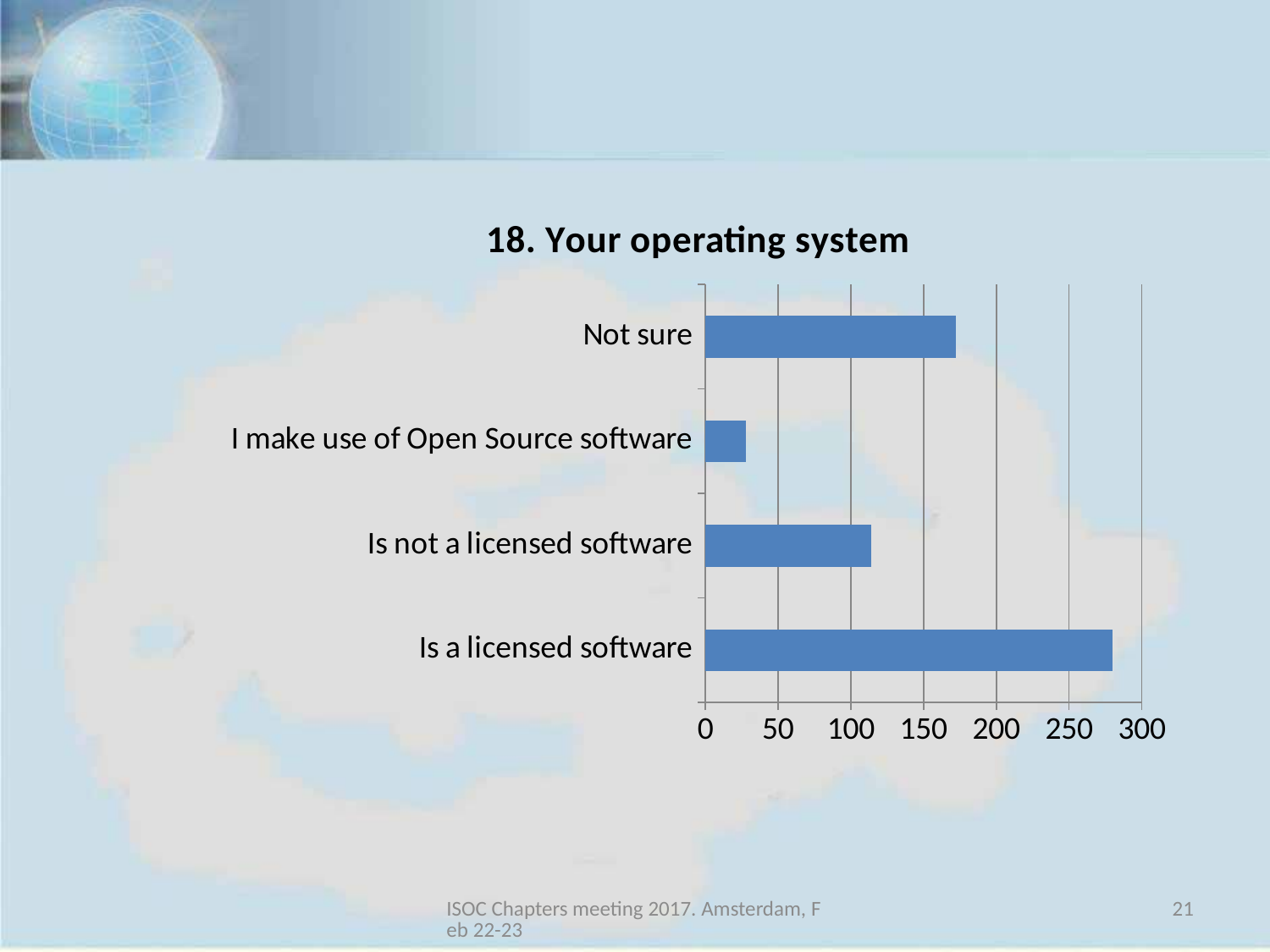
Which is larger, the value for 'Is a licensed software' or the value for 'Not sure'? Is a licensed software Which category has the lowest value? I make use of Open Source software Which category has the highest value? Is a licensed software Is the value for 'Not sure' greater or less than 150? greater Is the value for 'I make use of Open Source software' greater or less than 50? less Is the value for 'Is a licensed software' greater or less than 250? greater What is the title of the chart? 18. Your operating system What kind of chart is shown on the slide? bar chart What is the maximum value shown on the horizontal axis? 300 How many categories are shown in the chart? 4 Which is larger, the value for 'Not sure' or the value for 'Is not a licensed software'? Not sure